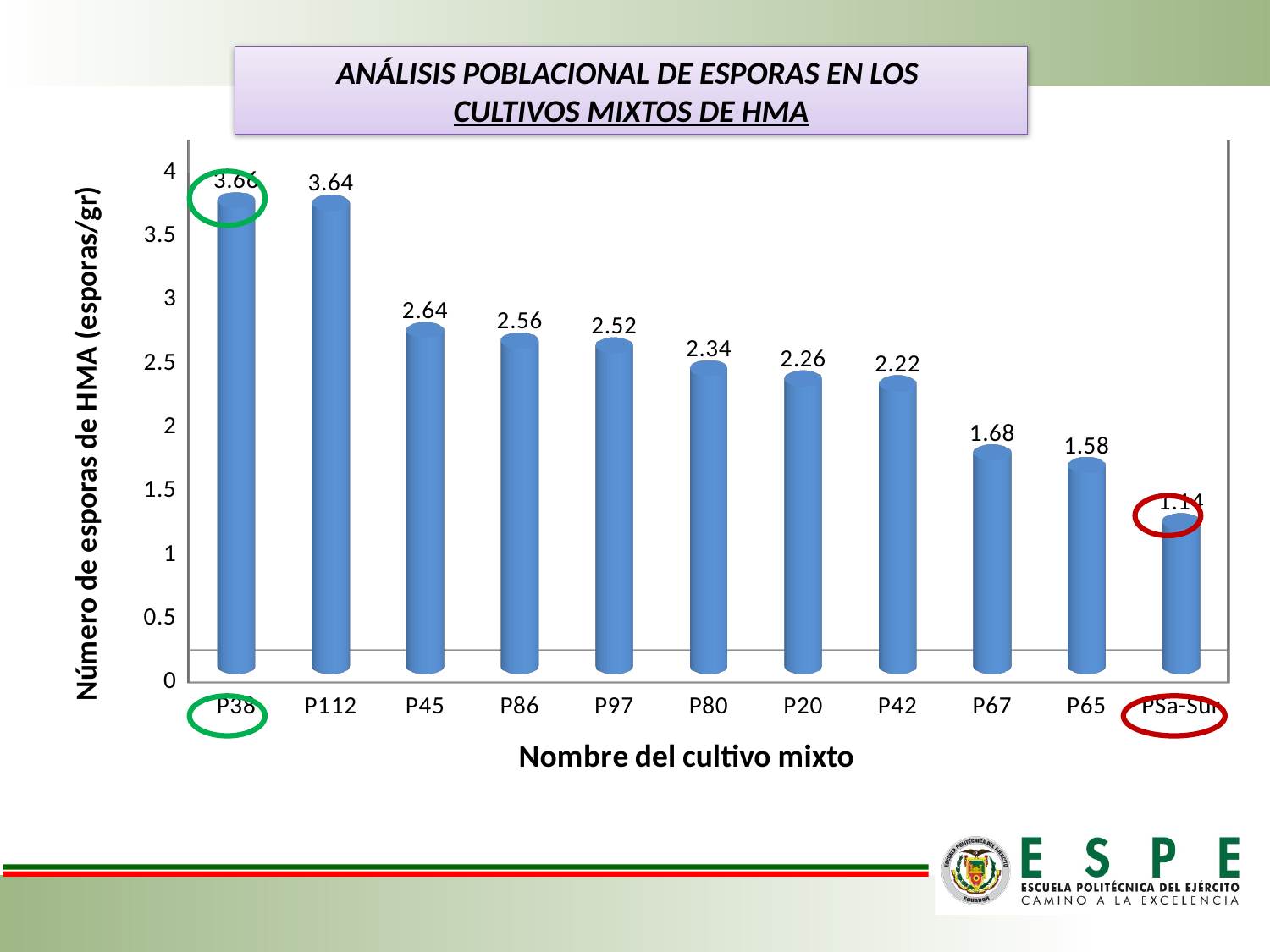
Which has a larger value, P80 or P20? P80 What is the difference between the values for P112 and P65? 2.06 What is the difference between the values for P45 and P86? 0.08 What is the value for P112? 3.64 What is the value for P86? 2.56 What is the value for P45? 2.64 What kind of chart is shown on the slide? bar chart What is the value for P67? 1.68 How many cultivos mixtos are shown on the x axis? 11 Which cultivo mixto has the lowest number of spores? PSa-Sur Do the values rise or fall from left to right along the x axis? fall Is the value for P38 greater or less than 3.5? greater